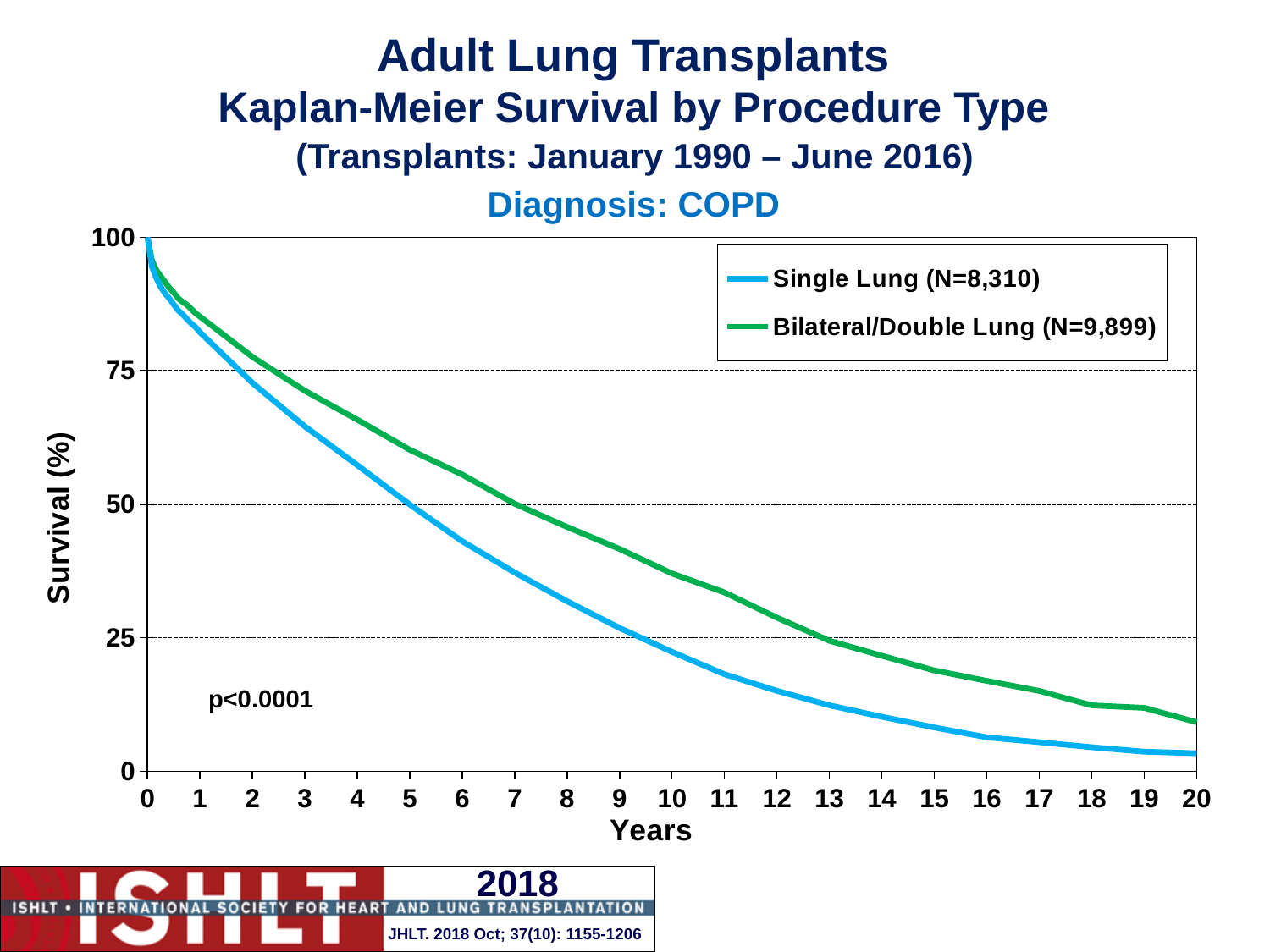
At 20 years, which series has the lower survival? Single Lung What kind of chart is shown on the slide? line chart Is the survival for Bilateral/Double Lung at 5 years greater or less than 50? greater Is the survival for Single Lung at 2 years greater or less than 75? less Is the survival for Bilateral/Double Lung at 15 years greater or less than 25? less What is the N for the Single Lung series in the legend? 8,310 How many series does the legend list? 2 What is the N for the Bilateral/Double Lung series in the legend? 9,899 At 10 years, which series has the higher survival, Single Lung or Bilateral/Double Lung? Bilateral/Double Lung Do the survival values rise or fall as years increase along the x axis? fall